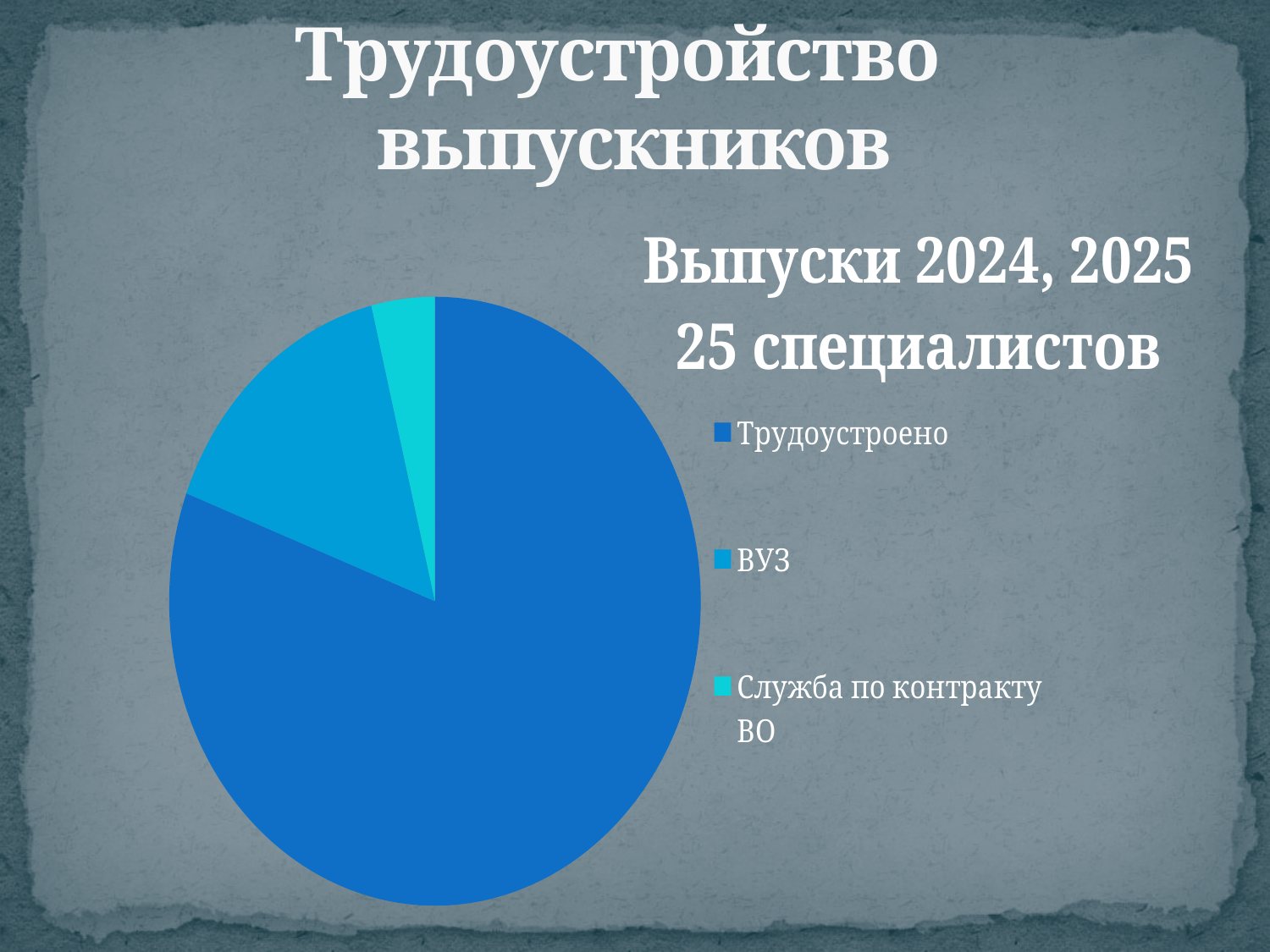
Which category has the smallest slice of the pie chart? Служба по контракту ВО What kind of chart is shown on the slide? pie chart How many slices does the pie chart have? 3 Which category has the largest slice of the pie chart? Трудоустроено Which slice is larger in the pie chart: Трудоустроено or ВУЗ? Трудоустроено What is the title of the pie chart? Выпуски 2024, 2025 25 специалистов Which slice is larger in the pie chart: ВУЗ or Служба по контракту ВО? ВУЗ Which legend entry is shown in the lightest (cyan) colour in the pie chart? Служба по контракту ВО How many entries does the legend of the pie chart list? 3